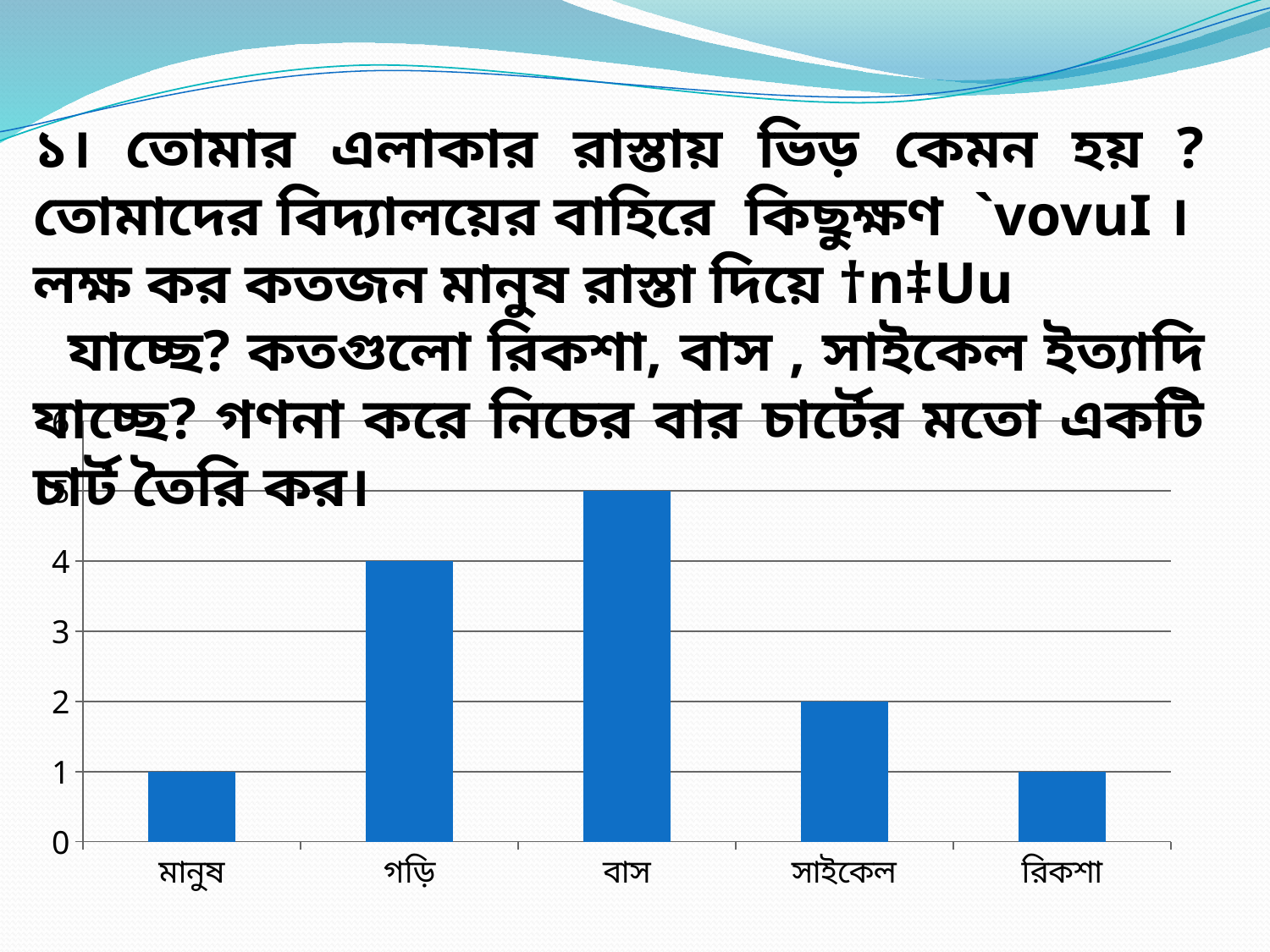
What is the difference between the values for গড়ি and রিকশা? 3 Which is larger, the value for গড়ি or the value for সাইকেল? গড়ি What is the value for মানুষ in the bar chart? 1 What kind of chart is shown on the slide? bar chart Which category has the highest bar in the chart? বাস What is the difference between the values for গড়ি and সাইকেল? 2 What is the value for রিকশা in the bar chart? 1 Is the value for সাইকেল greater or less than 3? less How many categories are shown on the x axis of the chart? 5 Is the value for বাস greater or less than 4? greater What is the value for গড়ি in the bar chart? 4 What is the value for সাইকেল in the bar chart? 2